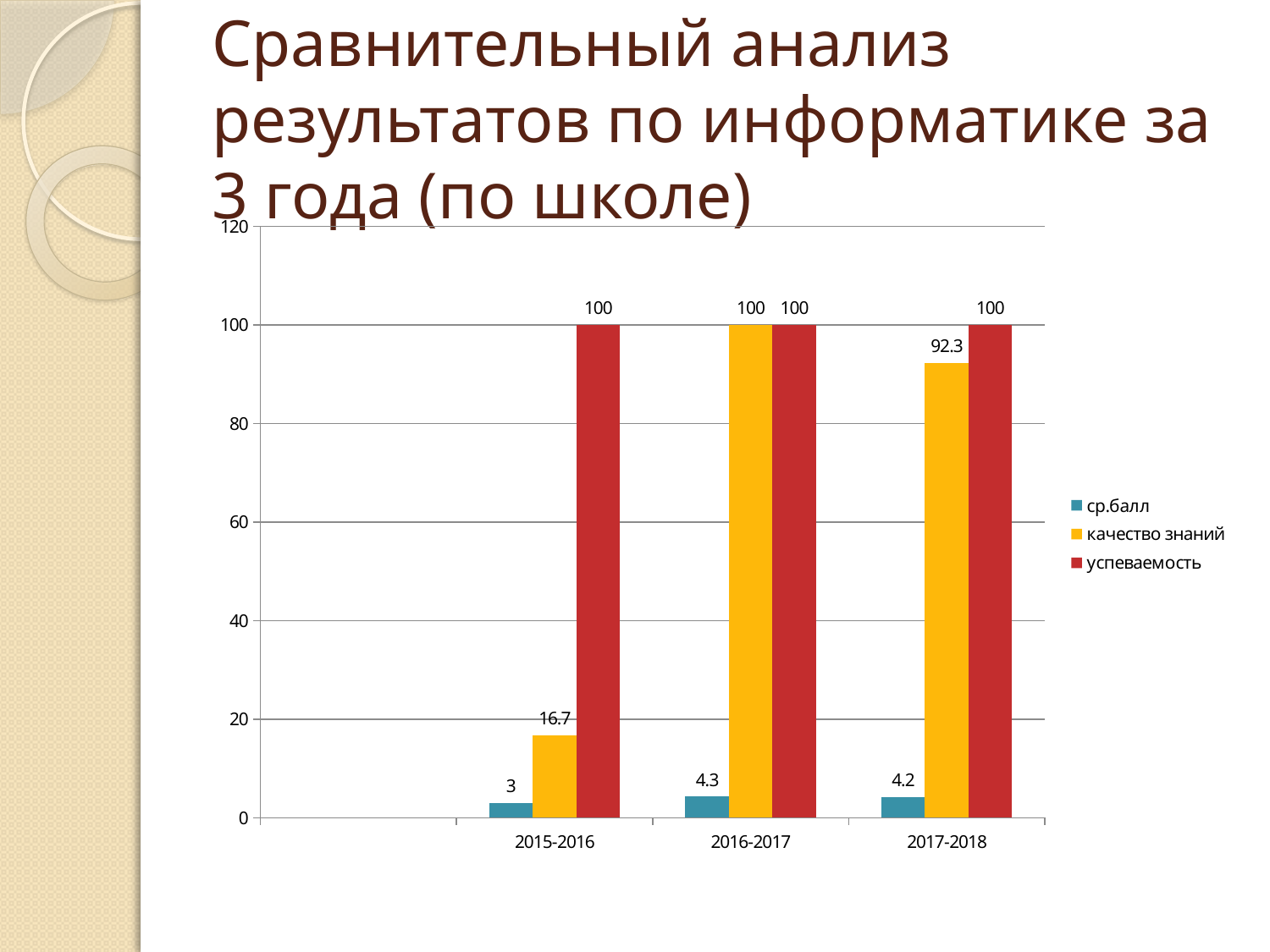
In which year is ср.балл the highest? 2016-2017 Which is larger: ср.балл in 2016-2017 or ср.балл in 2015-2016? 2016-2017 What is the value of успеваемость for 2016-2017? 100 How many series does the legend list? 3 Which series is shown in red? успеваемость What is the difference between качество знаний in 2016-2017 and in 2017-2018? 7.7 What is the value of ср.балл for 2015-2016? 3 What is the value of качество знаний for 2015-2016? 16.7 What is the value of качество знаний for 2017-2018? 92.3 In which year is качество знаний the lowest? 2015-2016 What kind of chart is shown on the slide? bar chart How many year categories are shown on the x axis? 3